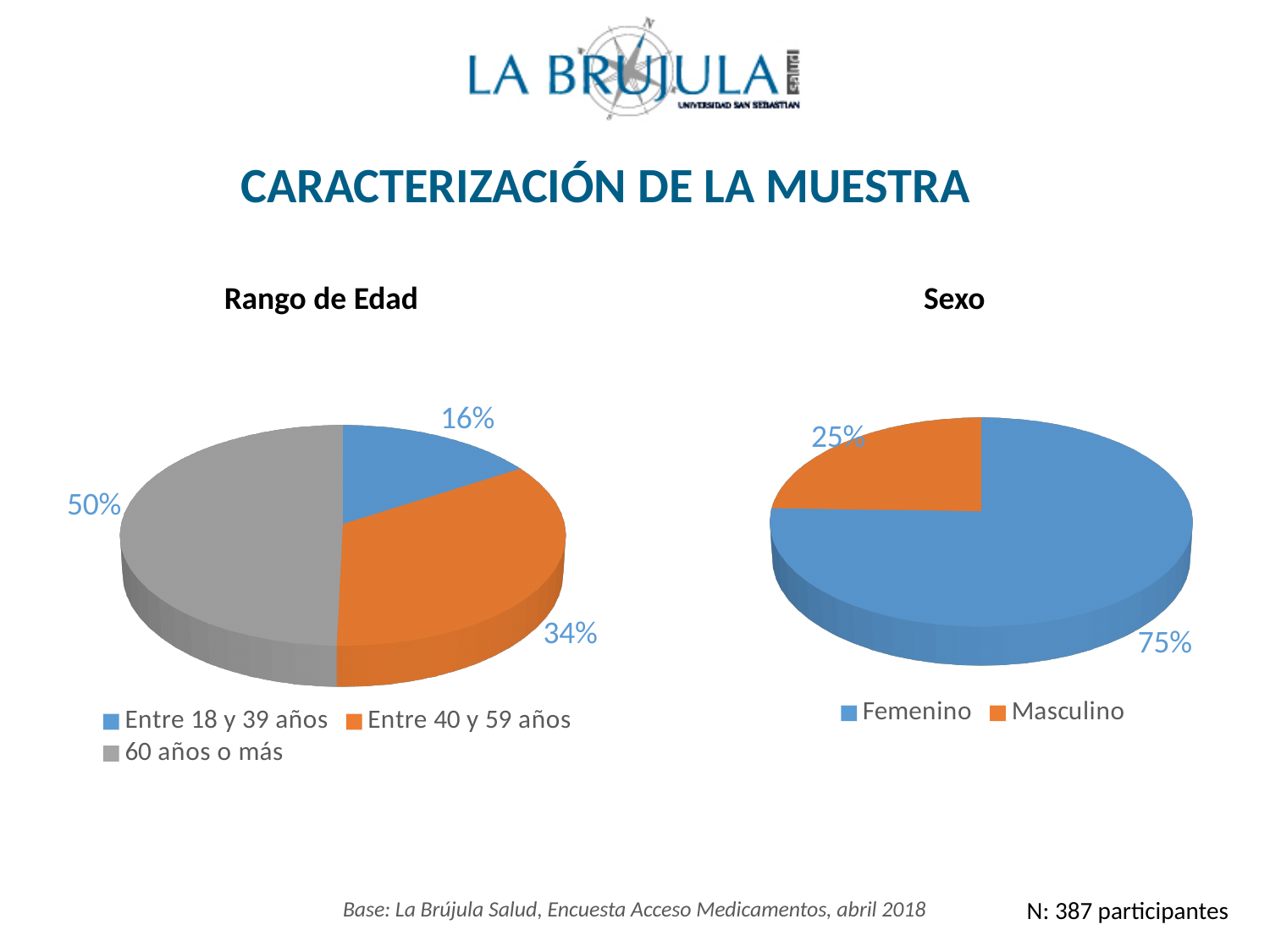
In the 'Sexo' chart, what is the difference between the 'Femenino' and 'Masculino' shares? 50% In the 'Rango de Edad' chart, how many age categories are shown? 3 In the 'Rango de Edad' chart, what is the difference between the shares of '60 años o más' and 'Entre 40 y 59 años'? 16% In the 'Sexo' chart, what share of the sample is 'Masculino'? 25% In the 'Rango de Edad' chart, what share of the sample is 'Entre 40 y 59 años'? 34% In the 'Rango de Edad' chart, what share of the sample is 'Entre 18 y 39 años'? 16% What type of chart is the 'Sexo' chart? Pie chart In the 'Sexo' chart, what share of the sample is 'Femenino'? 75% In the 'Rango de Edad' chart, which age group has the smallest share? Entre 18 y 39 años In the 'Rango de Edad' chart, which age group has the largest share? 60 años o más In the 'Sexo' chart, which category is larger, 'Femenino' or 'Masculino'? Femenino In the 'Rango de Edad' chart, what share of the sample is '60 años o más'? 50%